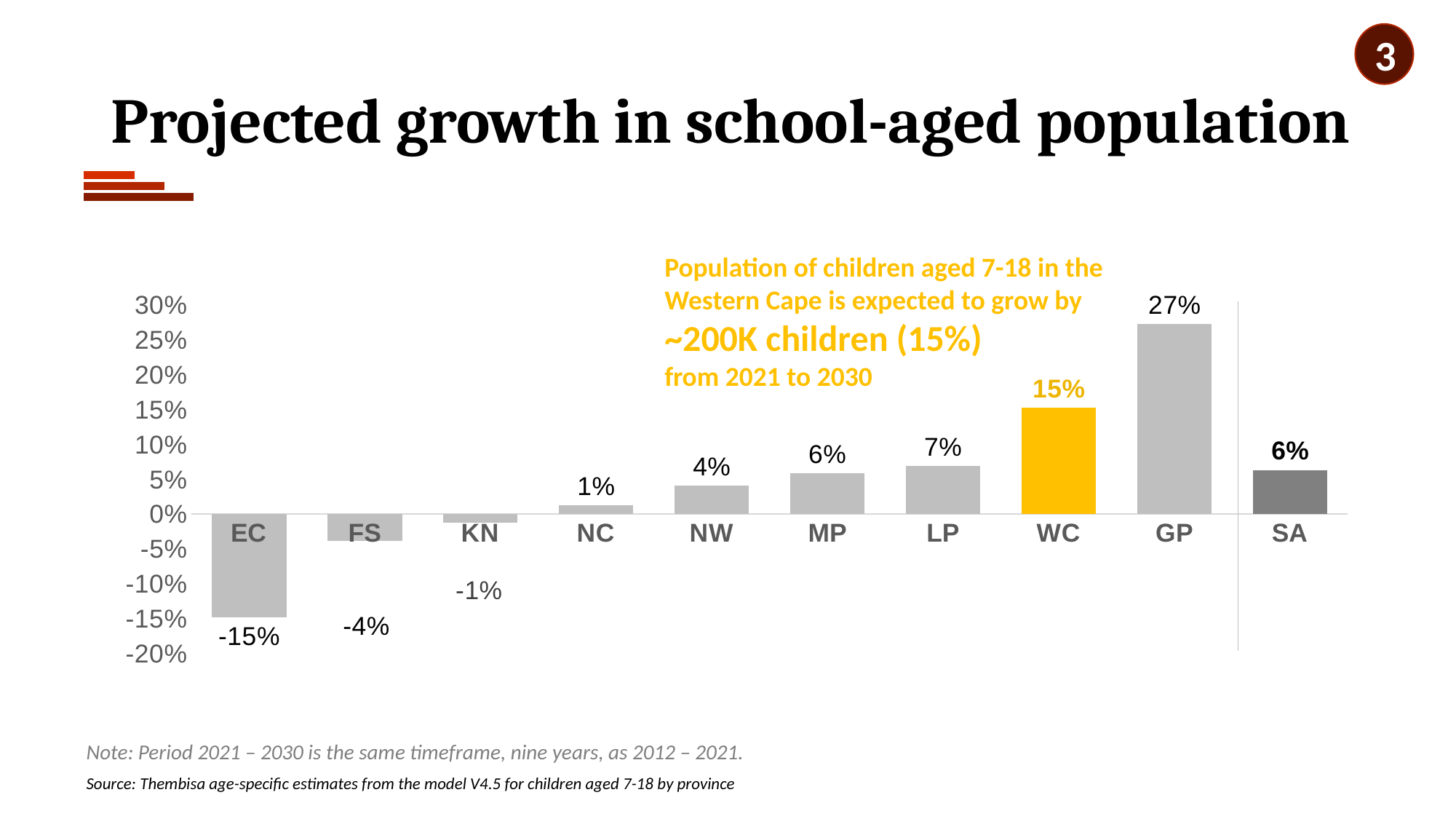
What is the difference between the values for GP and WC? 12% Which bar is highlighted in yellow? WC Which category has the highest projected growth? GP What is the projected growth value for WC? 15% How many categories are shown on the x axis? 10 What kind of chart is shown on the slide? bar chart What is the projected growth value for EC? -15% Which has a larger value, LP or MP? LP Is the value for GP greater or less than 25%? greater Which category has the lowest projected growth? EC What is the value for FS? -4% What is the projected growth value for SA? 6%